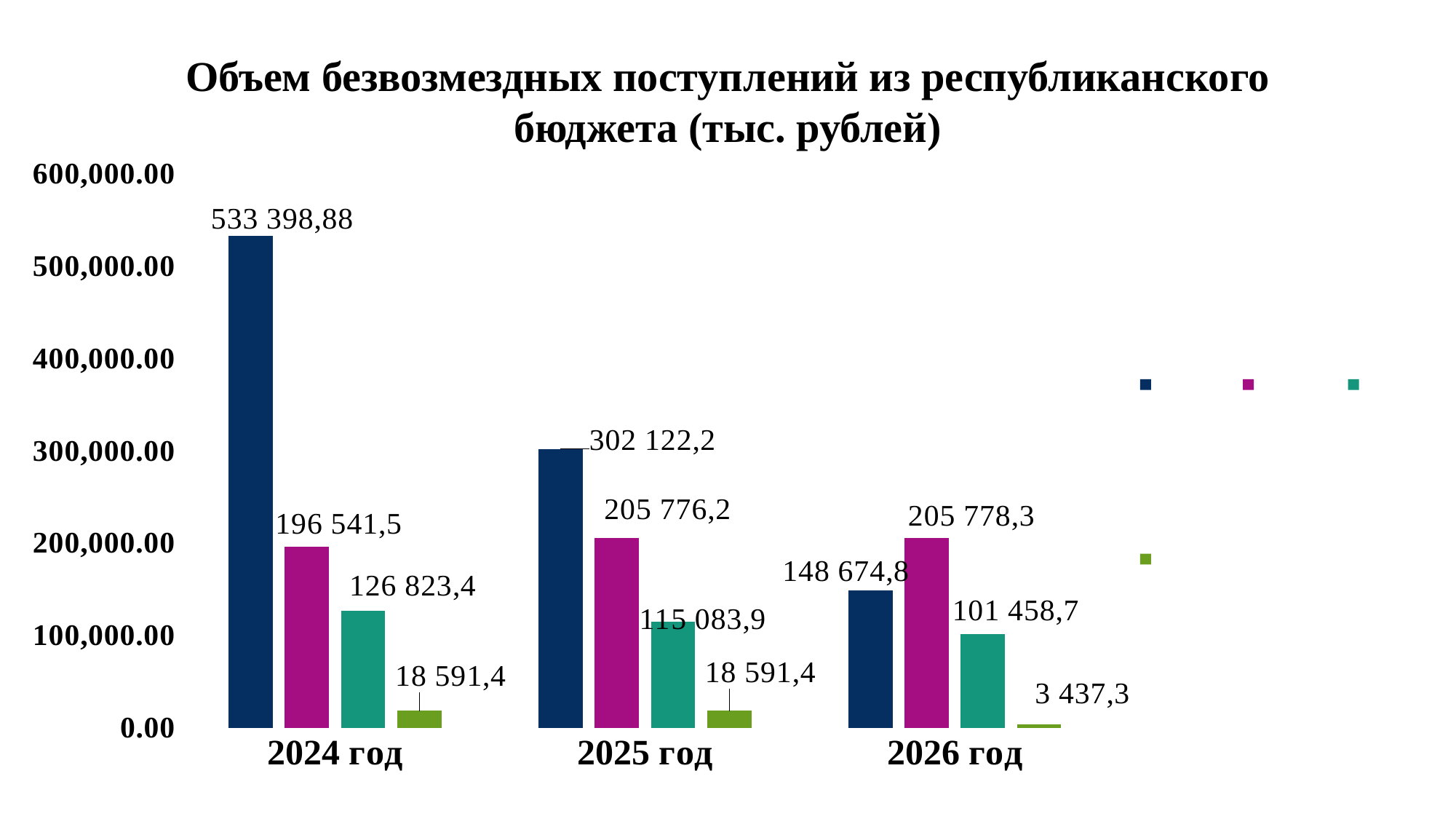
Which year has the highest dark blue bar? 2024 год What is the value of the dark blue bar for 2024 год? 533 398,88 What is the value of the magenta bar for 2026 год? 205 778,3 Do the dark blue bars rise or fall from 2024 год to 2026 год? fall What is the difference between the green bars for 2025 год and 2026 год? 15 154,1 Which is larger for 2026 год: the dark blue bar or the magenta bar? the magenta bar How many year categories are shown on the x axis? 3 What is the value of the teal bar for 2025 год? 115 083,9 Which year has the lowest green bar? 2026 год What is the value of the green bar for 2026 год? 3 437,3 What kind of chart is shown on the slide? bar chart What is the difference between the dark blue and magenta bars for 2024 год? 336 857,38